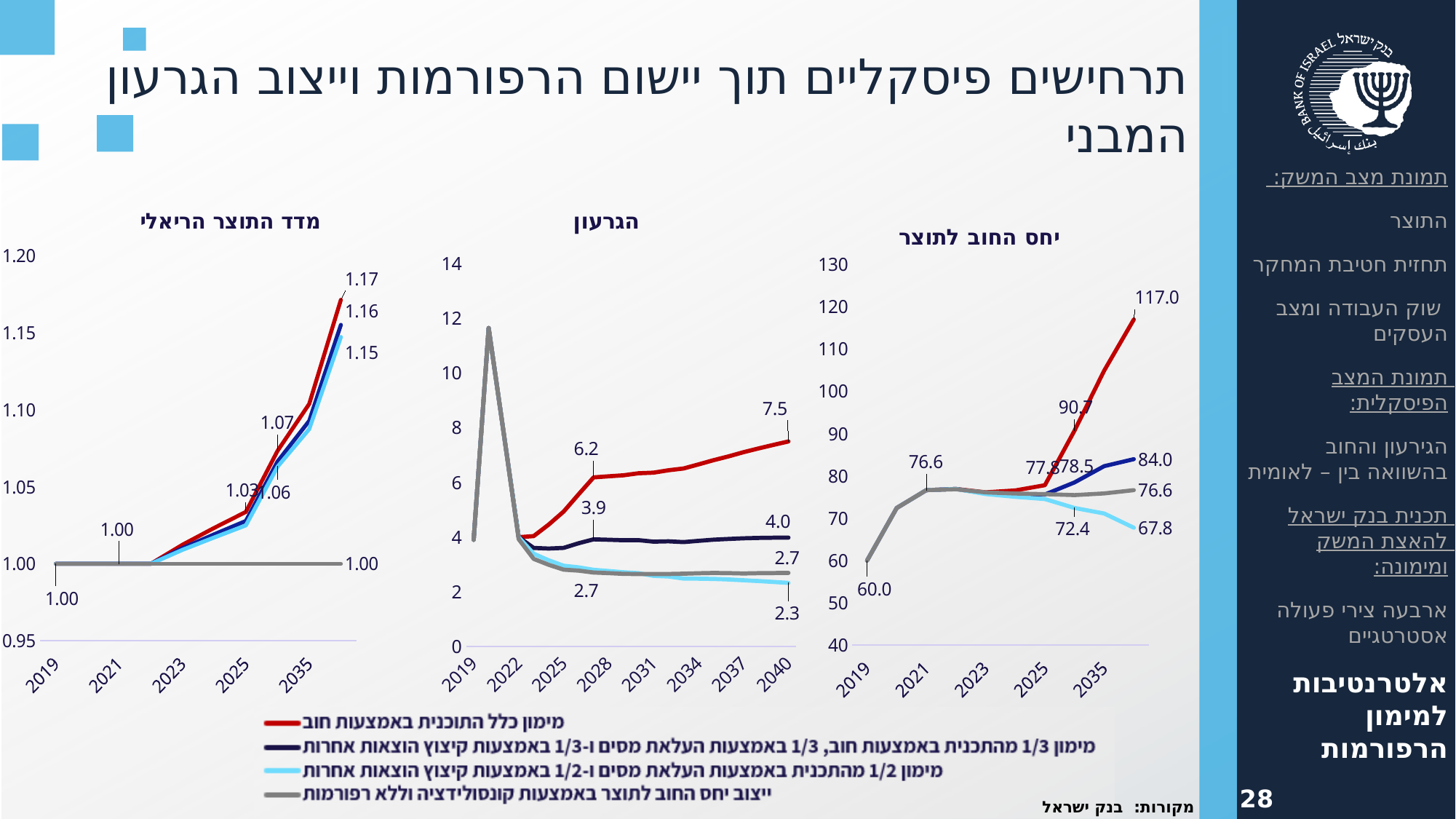
What kind of chart is used for the three charts on the slide? line chart In the chart titled הגירעון, is the peak of the gray line around 2020 greater or less than 10? greater How many charts are shown on the slide? 3 In the chart titled יחס החוב לתוצר, what is the final labelled value of the light blue series? 67.8 In the chart titled מדד התוצר הריאלי, which series reaches the highest final value, and what is it? the red series, 1.17 In the chart titled הגירעון, which series has the lowest labelled value in 2040? the light blue series (2.3) How many series does the legend at the bottom of the slide list? 4 In the chart titled יחס החוב לתוצר, what is the value labelled at 2019? 60.0 In the chart titled יחס החוב לתוצר, what is the final labelled value of the dark blue series? 84.0 In the chart titled יחס החוב לתוצר, what is the difference between the final values of the red series (117.0) and the dark blue series (84.0)? 33.0 In the chart titled יחס החוב לתוצר, what is the final labelled value of the red series (מימון כלל התוכנית באמצעות חוב)? 117.0 In the chart titled הגירעון, what is the final labelled value of the red series in 2040? 7.5